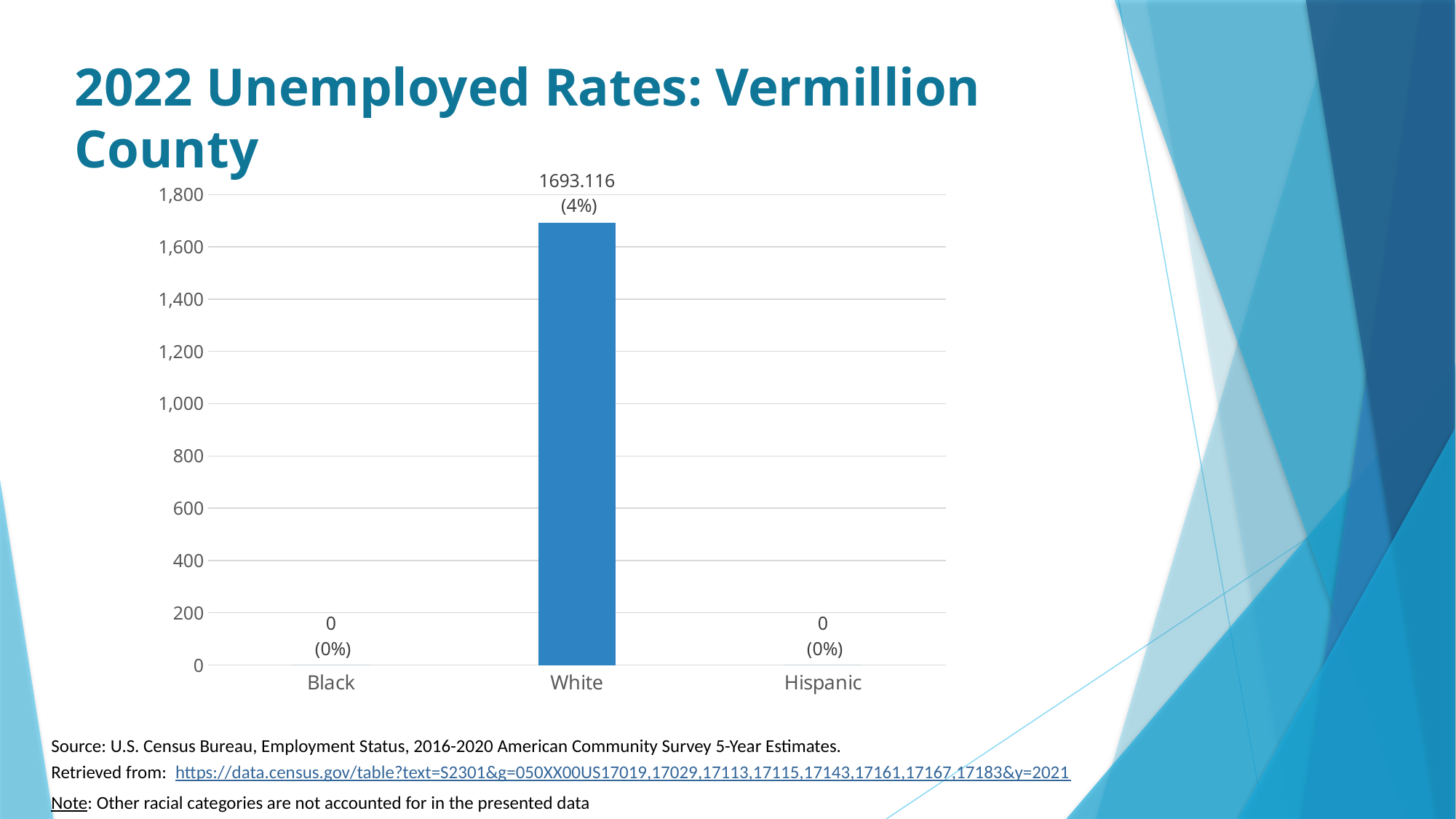
What is the value shown for Black? 0 What is the title of the slide? 2022 Unemployed Rates: Vermillion County Is the value for White greater or less than 1,600? greater What is the difference between the values for White and Black? 1693.116 What is the value shown for White? 1693.116 Which is larger, the value for White or the value for Hispanic? White What kind of chart is shown on the slide? bar chart What percentage is shown in the data label for White? 4% How many categories are shown on the x axis? 3 What is the value shown for Hispanic? 0 What is the highest value labelled on the y axis? 1,800 Which category has the highest value? White